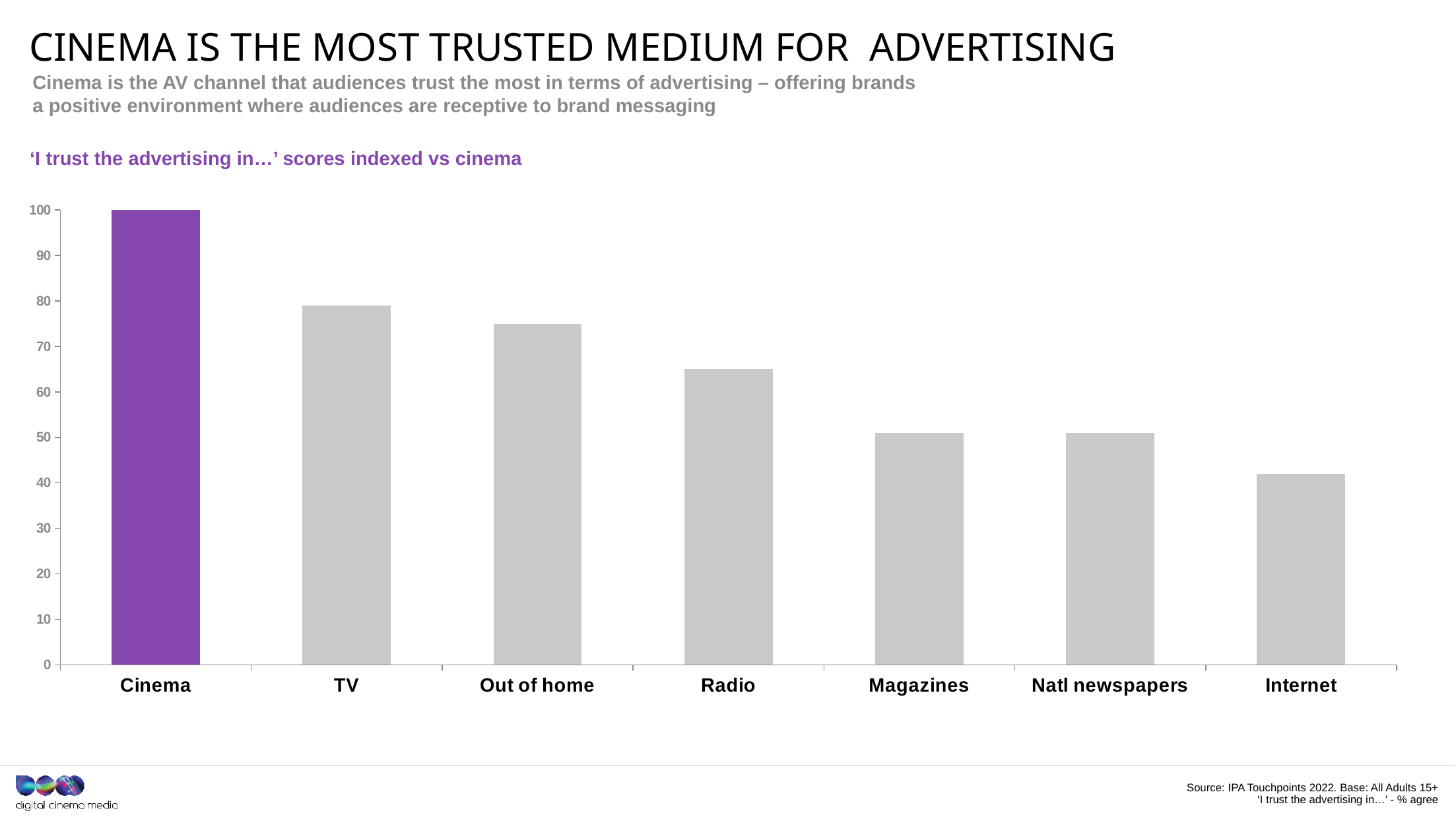
Is the value for TV greater or less than 70? greater What kind of chart is shown? Bar chart What is the value for Cinema? 100 Is the value for Radio greater or less than 60? greater Is the value for Internet greater or less than 50? less How many categories are shown on the x axis? 7 Which bar is coloured purple rather than grey? Cinema Which is larger, the value for TV or the value for Radio? TV Which is larger, the value for Magazines or the value for Internet? Magazines Which category has the lowest value? Internet Which category has the highest value? Cinema